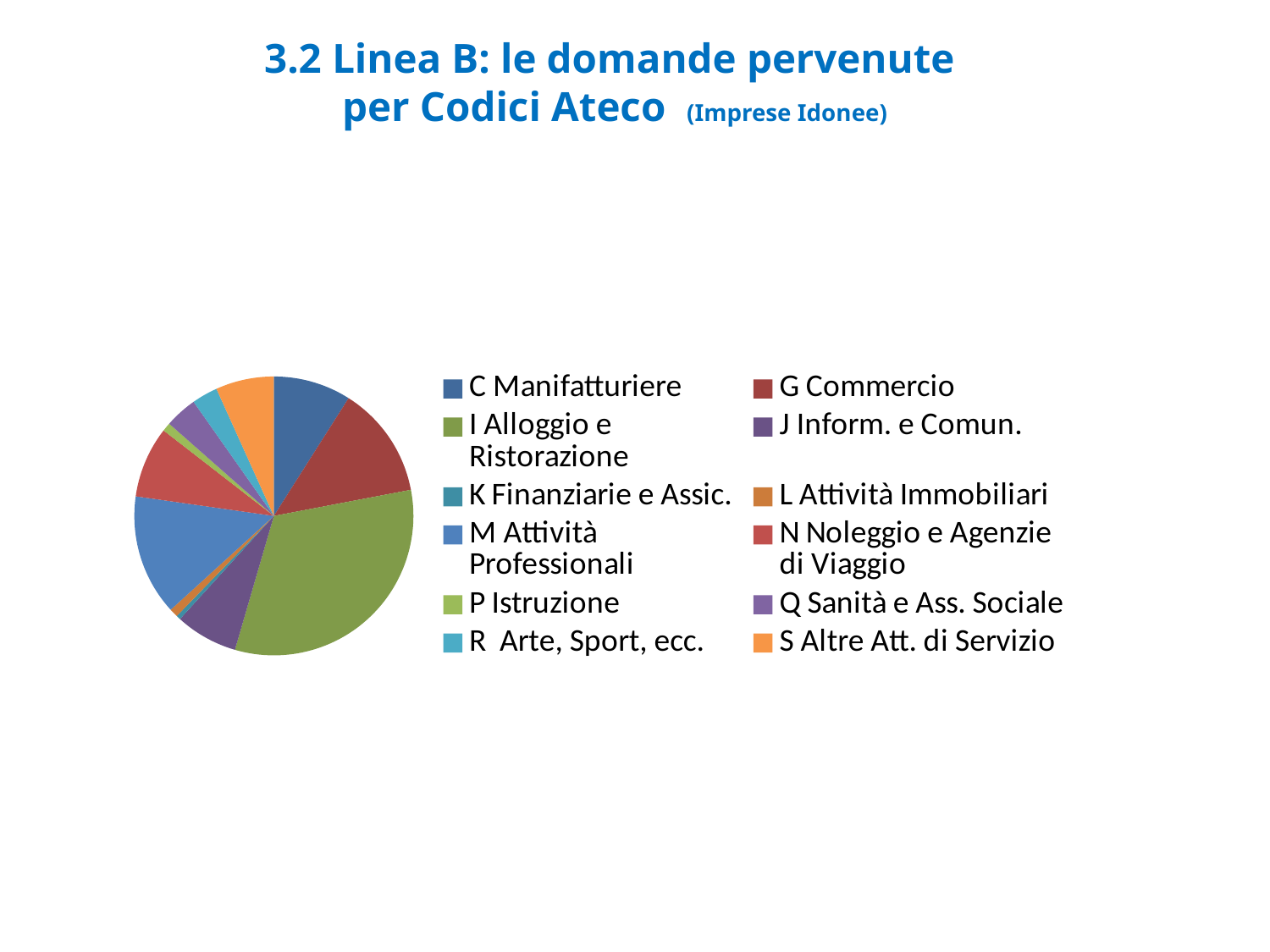
Which slice is larger, I Alloggio e Ristorazione or C Manifatturiere? I Alloggio e Ristorazione Which slice is larger, N Noleggio e Agenzie di Viaggio or L Attività Immobiliari? N Noleggio e Agenzie di Viaggio How many categories does the legend of the pie chart list? 12 What kind of chart is shown on the slide? pie chart Which slice is larger, M Attività Professionali or S Altre Att. di Servizio? M Attività Professionali Which category is shown in green in the pie chart legend, listed second? I Alloggio e Ristorazione What is the title of the slide containing the pie chart? 3.2 Linea B: le domande pervenute per Codici Ateco (Imprese Idonee) Which category has the largest slice of the pie chart? I Alloggio e Ristorazione